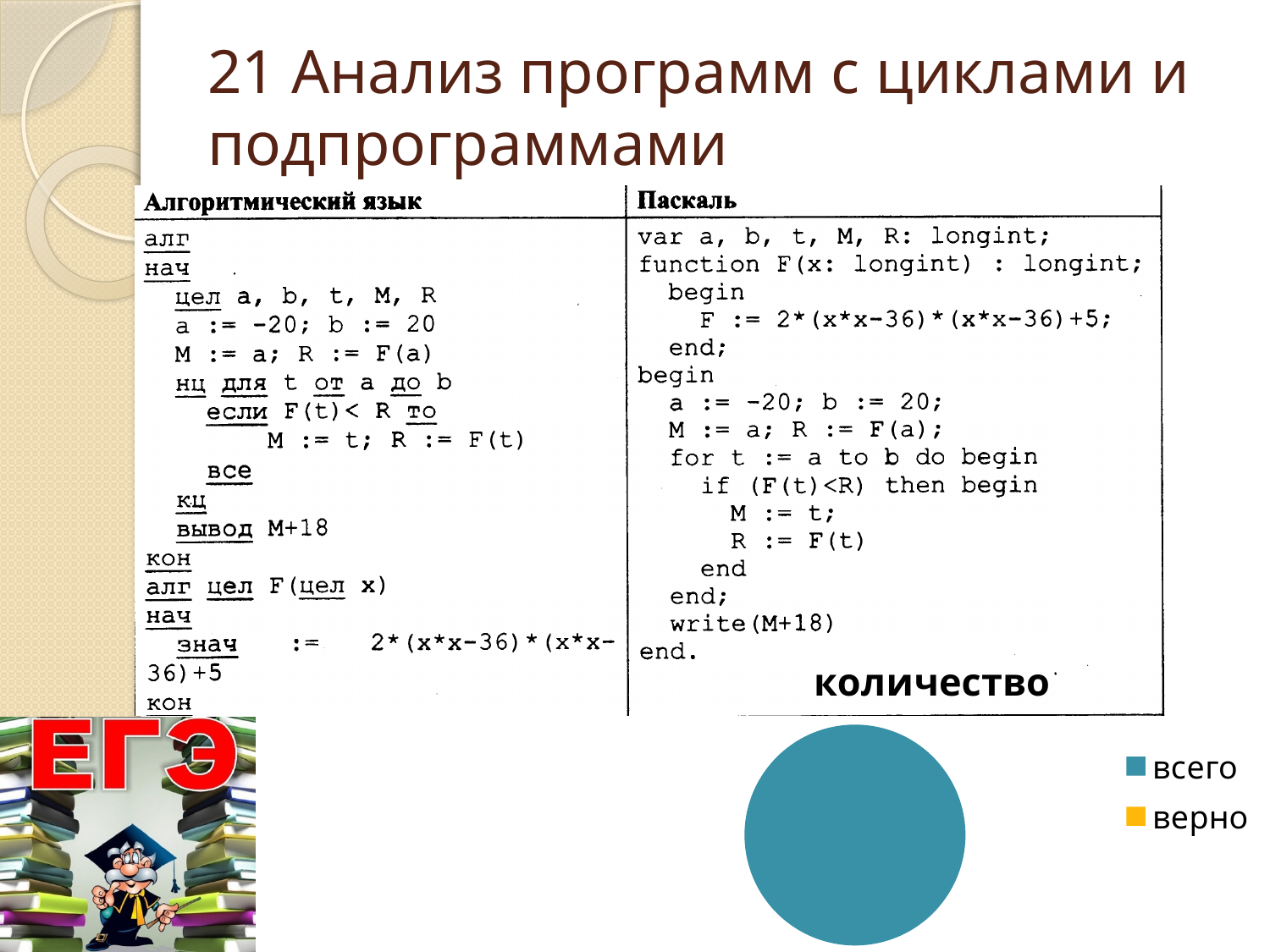
What kind of chart is shown at the bottom of the slide? pie chart Which of the two categories, всего or верно, has the larger slice in the pie chart? всего How many entries does the legend of the pie chart list? 2 What is the title of the pie chart? количество Which category takes up the largest share of the pie chart? всего Which legend entry of the pie chart is shown in blue? всего